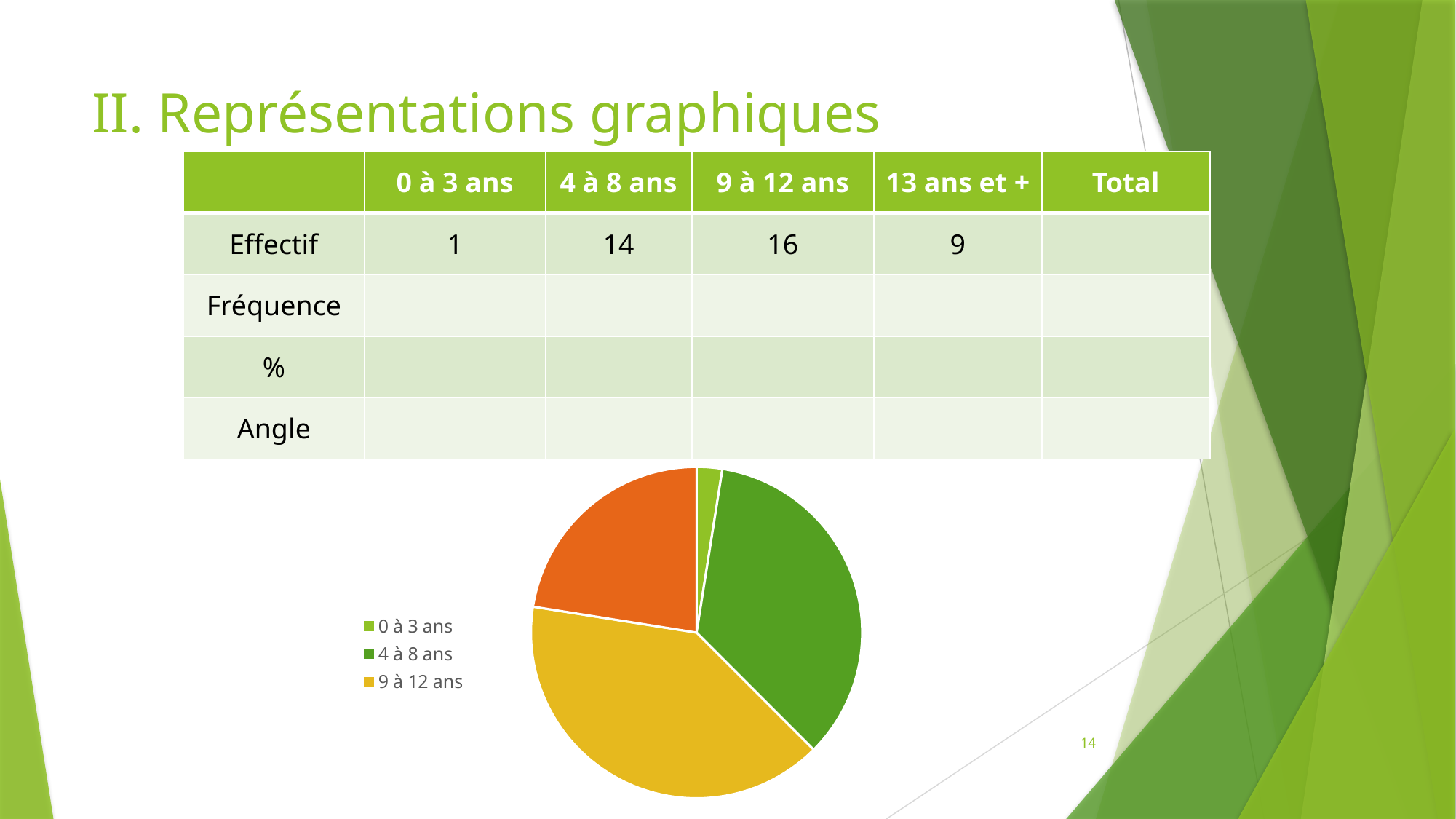
In the pie chart, which slice is larger: 9 à 12 ans or 4 à 8 ans? 9 à 12 ans According to the table above the pie chart, what is the Effectif for 0 à 3 ans? 1 According to the table above the pie chart, what is the Effectif for 4 à 8 ans? 14 According to the table above the pie chart, what is the Effectif for 9 à 12 ans? 16 How many entries does the pie chart's legend list? 3 How many slices does the pie chart have? 4 Which category has the smallest slice in the pie chart? 0 à 3 ans In the pie chart, which slice is larger: 4 à 8 ans or 0 à 3 ans? 4 à 8 ans What is the difference between the Effectif for 9 à 12 ans and for 4 à 8 ans in the table? 2 What kind of chart is shown on the slide? pie chart Which category has the largest slice in the pie chart? 9 à 12 ans What colour is the 9 à 12 ans slice in the pie chart? yellow